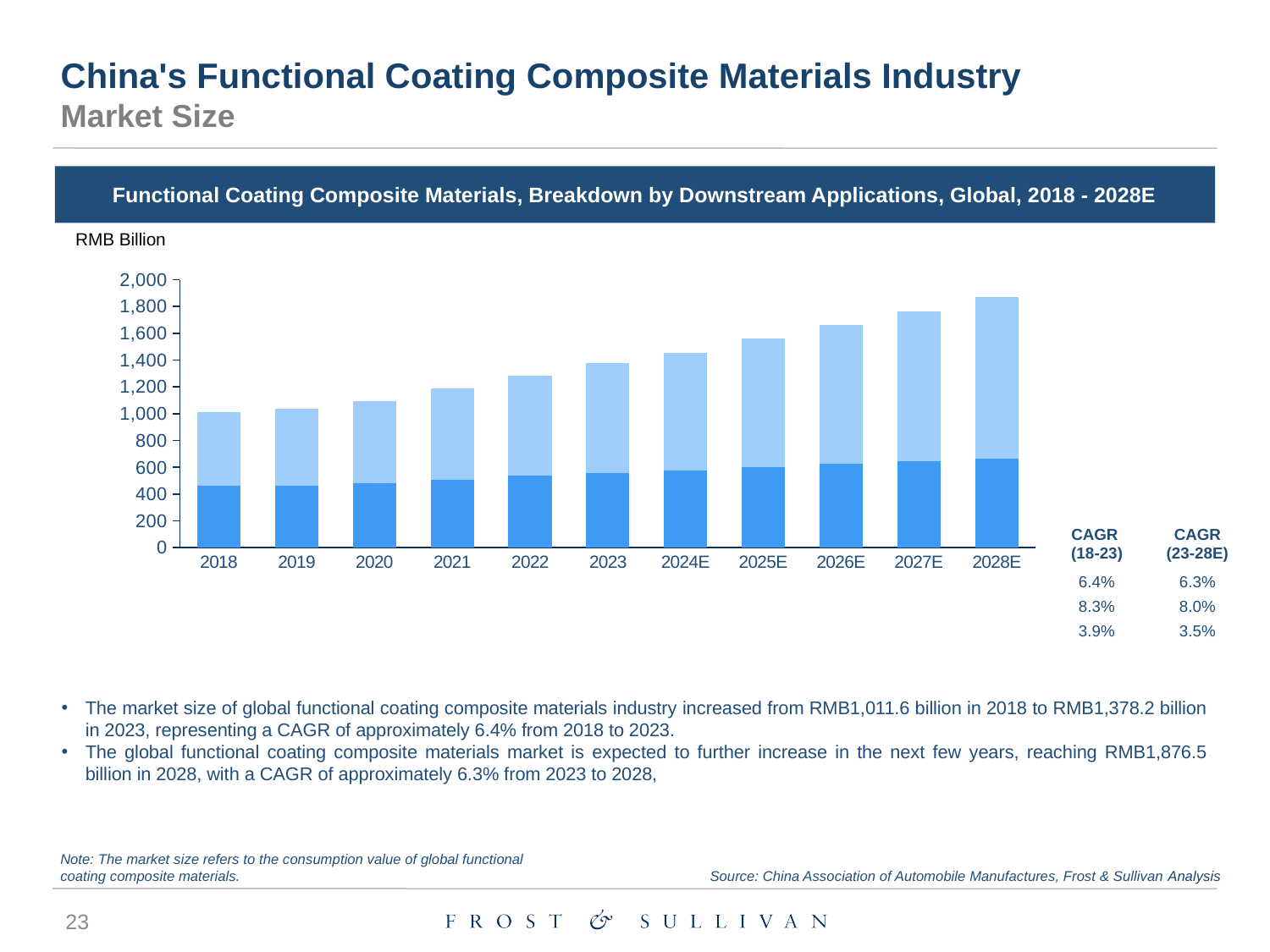
Do the total bar heights rise or fall from 2018 to 2028E? Rise How many years are shown on the x axis of the chart? 11 Which year has the shortest total bar in the chart? 2018 Is the dark blue (bottom) segment for 2018 greater or less than 600? less Is the total value for 2018 greater or less than 1,200? less What is the title of the chart? Functional Coating Composite Materials, Breakdown by Downstream Applications, Global, 2018 - 2028E Which year has the tallest total bar in the chart? 2028E What kind of chart is shown on the slide? Stacked bar chart Is the total value for 2023 greater or less than 1,200? greater What unit is the chart's y axis measured in? RMB Billion